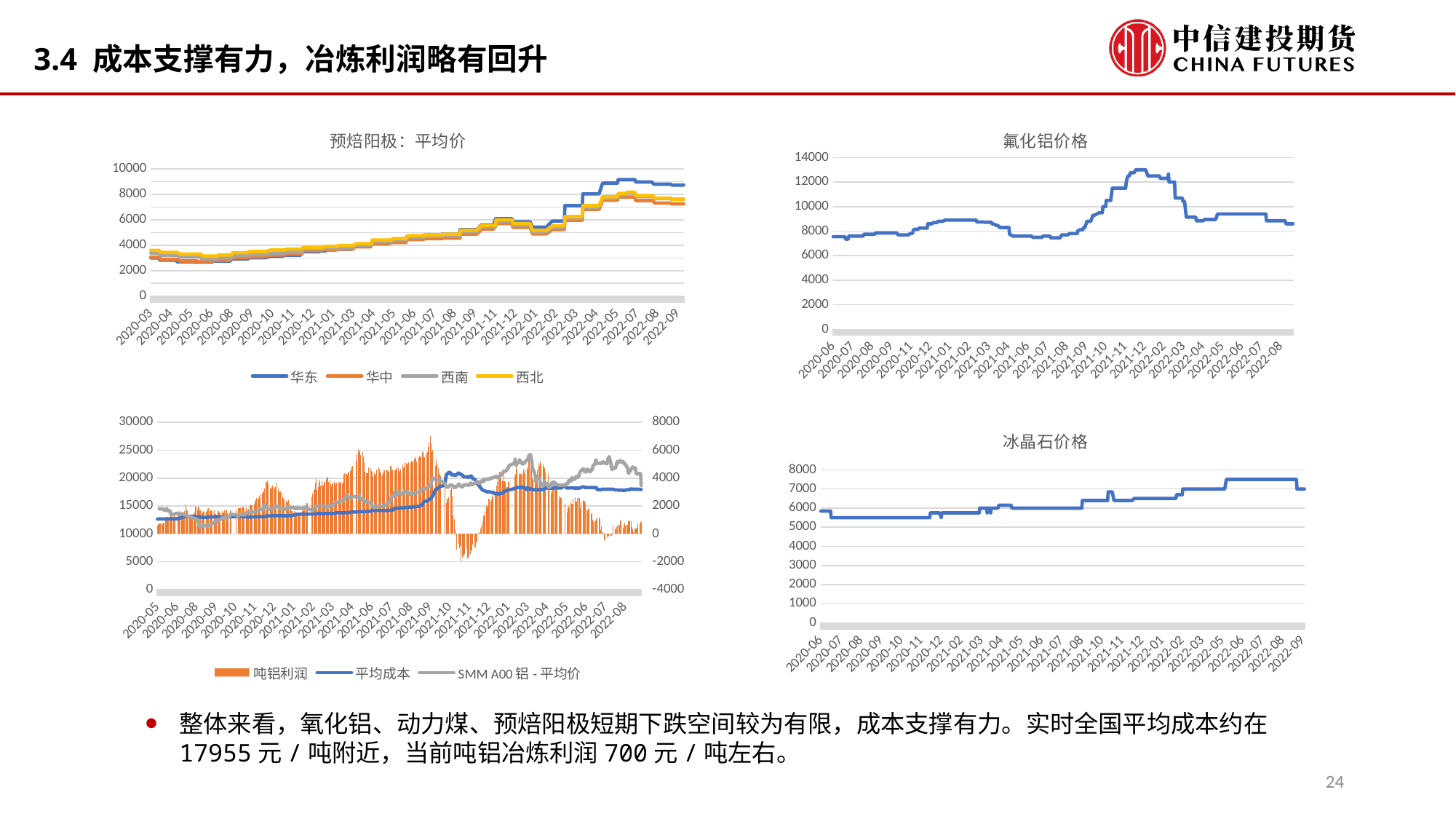
On the chart titled 预焙阳极：平均价, is the value for 华东 at 2022-05 greater or less than 8000? greater On the chart titled 氟化铝价格, is the value at 2020-06 greater or less than 8000? less On the chart titled 氟化铝价格, is the peak value around 2021-12 greater or less than 12000? greater What kind of chart is the chart titled 氟化铝价格? line chart On the chart titled 预焙阳极：平均价, how many series does the legend list? 4 On the bottom-left chart, which series is drawn as bars rather than a line? 吨铝利润 On the chart titled 预焙阳极：平均价, do the values generally rise or fall from 2020-03 to 2022-05? rise On the bottom-left chart, how many series does the legend list? 3 What kind of chart is the chart titled 预焙阳极：平均价? line chart On the chart titled 冰晶石价格, do the values generally rise or fall from 2020-06 to 2022-09? rise